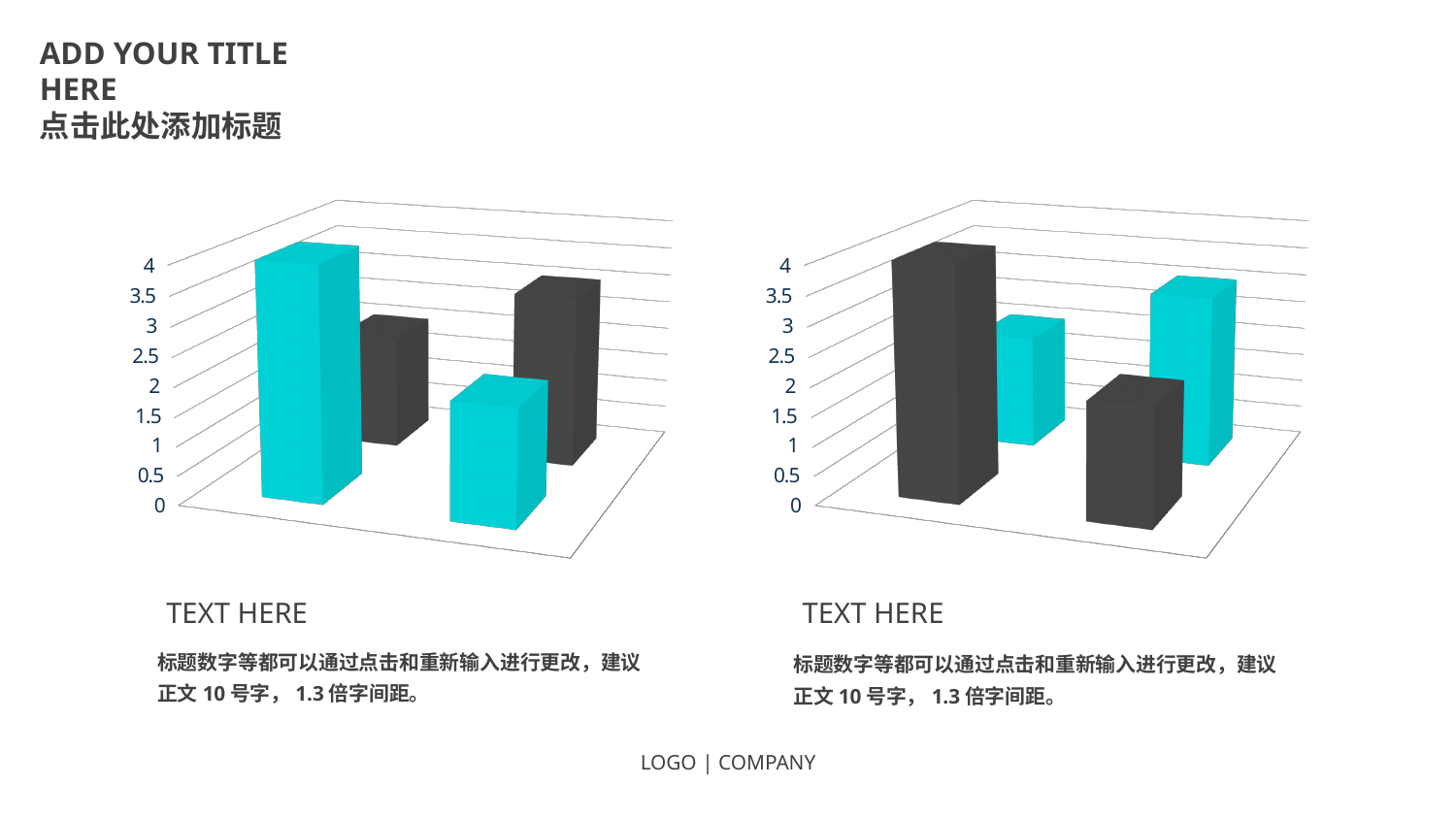
What kind of chart is the chart on the left side of the slide? bar chart In the chart on the left side of the slide, which bar is the tallest, counting from the left? the first bar How many bars are plotted in the chart on the right side of the slide? 4 In the chart on the right side of the slide, is the value of the first bar from the left greater or less than 2? greater In the chart on the right side of the slide, which bar is the tallest, counting from the left? the first bar What kind of chart is the chart on the right side of the slide? bar chart What is the highest value shown on the vertical axis of the chart on the left side of the slide? 4 How many bars are plotted in the chart on the left side of the slide? 4 In the chart on the left side of the slide, is the value of the third bar from the left greater or less than 3? less In the chart on the left side of the slide, is the first bar from the left taller or shorter than the second bar? taller